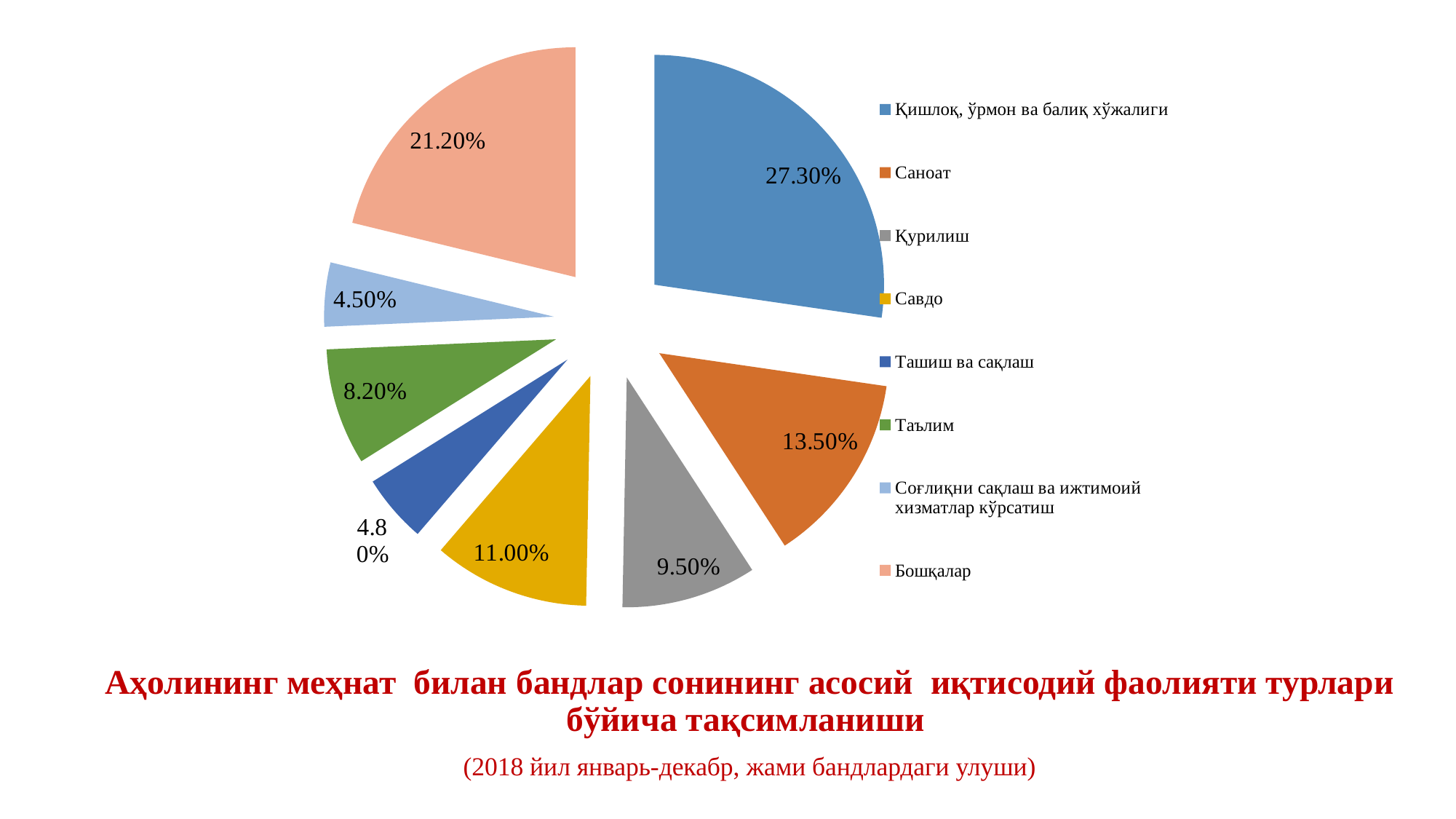
What is the value shown for Соғлиқни сақлаш ва ижтимоий хизматлар кўрсатиш? 4.50% What is the difference between the shares of Қишлоқ, ўрмон ва балиқ хўжалиги and Бошқалар? 6.10% What is the value shown for Бошқалар? 21.20% How many categories does the pie chart have? 8 Which category has the largest slice of the pie? Қишлоқ, ўрмон ва балиқ хўжалиги What is the value shown for Таълим? 8.20% What kind of chart is shown on the slide? Pie chart What colour is the slice for Саноат? Orange What is the value shown for Саноат? 13.50% What share of the pie does Қишлоқ, ўрмон ва балиқ хўжалиги have? 27.30% Which is larger, the share for Савдо or the share for Қурилиш? Савдо Which category has the smallest slice of the pie? Соғлиқни сақлаш ва ижтимоий хизматлар кўрсатиш